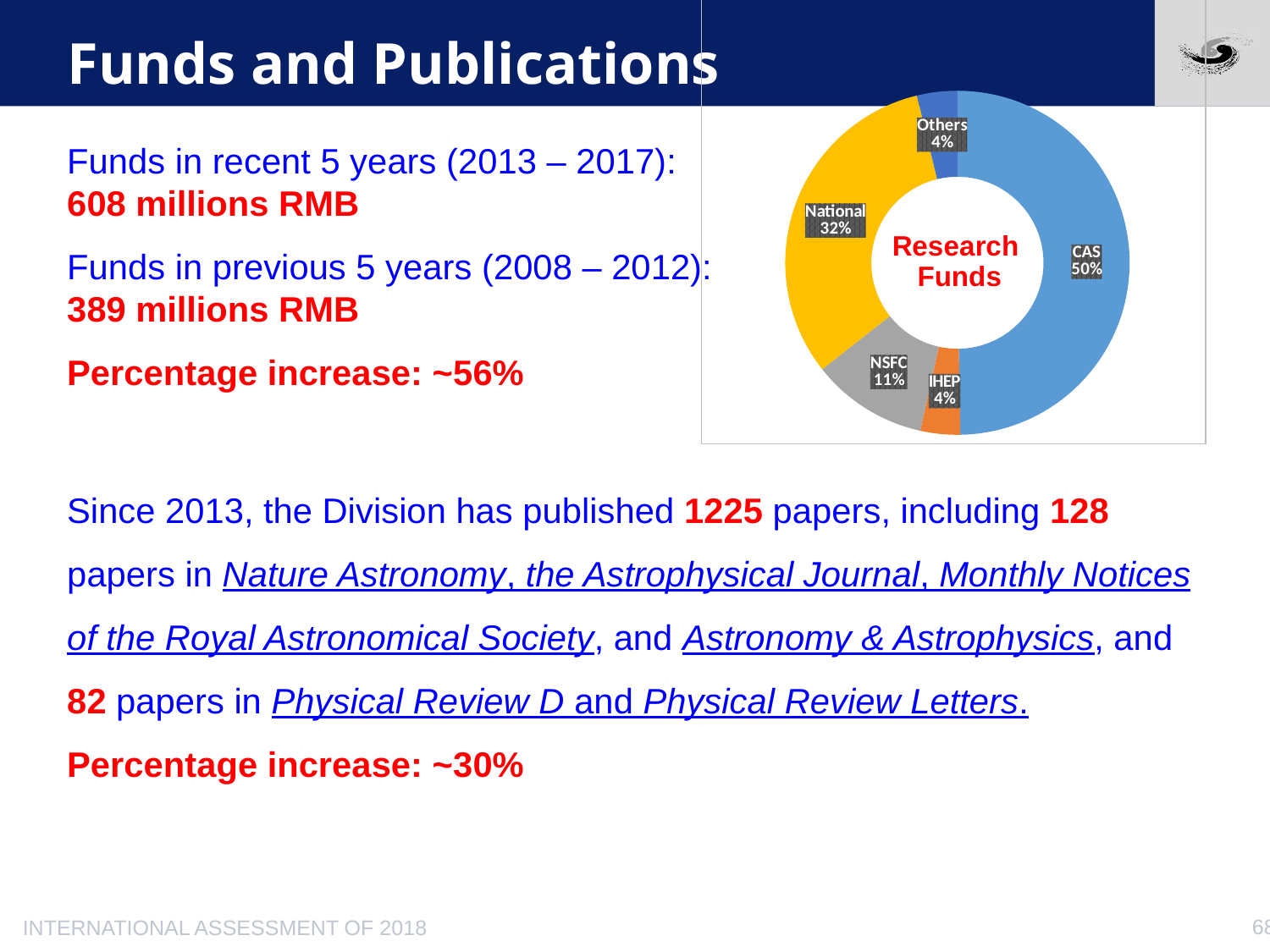
What share of the Research Funds chart does NSFC account for? 11% What is the title shown in the centre of the doughnut chart? Research Funds Which has a larger share in the Research Funds chart, National or NSFC? National What share of the Research Funds chart does CAS account for? 50% How many categories are shown in the Research Funds chart? 5 What kind of chart is the Research Funds chart? Doughnut (pie) chart What share of the Research Funds chart does IHEP account for? 4% What colour is the CAS segment in the Research Funds chart? Blue What is the combined share of National and NSFC in the Research Funds chart? 43% What share of the Research Funds chart does National account for? 32% Which category has the largest share in the Research Funds chart? CAS What is the difference in percentage points between the CAS and National shares in the Research Funds chart? 18